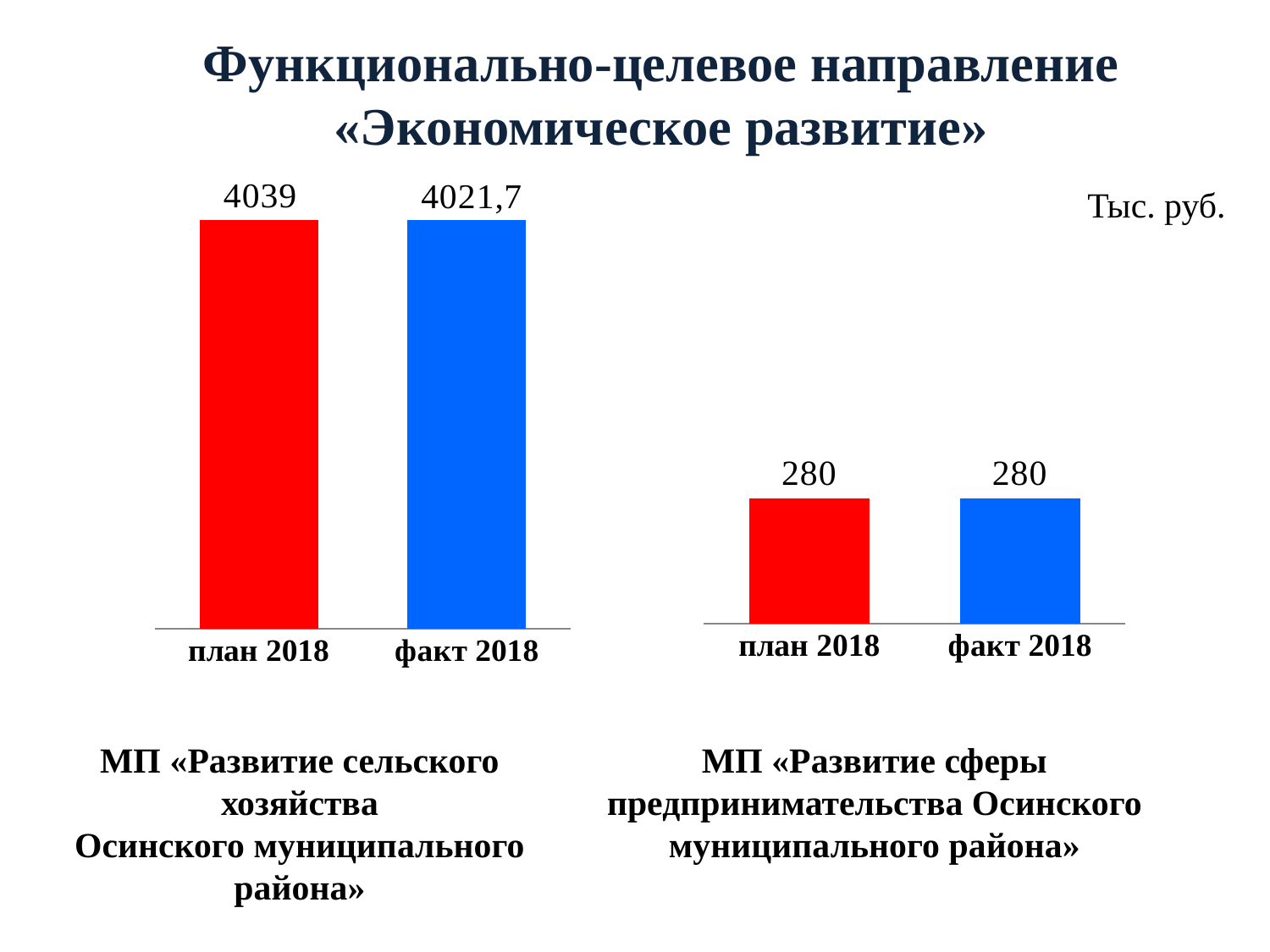
In the right chart (МП «Развитие сферы предпринимательства Осинского муниципального района»), what is the value for факт 2018? 280 How many bars are shown in the left chart? 2 How many bars are shown in the right chart? 2 What unit of measurement is indicated on the slide for the chart values? Тыс. руб. In the left chart (МП «Развитие сельского хозяйства Осинского муниципального района»), what is the value for план 2018? 4039 In the left chart, what is the difference between план 2018 and факт 2018? 17,3 In the left chart, which category has the higher value, план 2018 or факт 2018? план 2018 In the right chart, what is the difference between план 2018 and факт 2018? 0 In the right chart (МП «Развитие сферы предпринимательства Осинского муниципального района»), what is the value for план 2018? 280 What type of chart is used on the left side of the slide? Bar chart In the left chart (МП «Развитие сельского хозяйства Осинского муниципального района»), what is the value for факт 2018? 4021,7 In the right chart, what colour is the bar for факт 2018? Blue